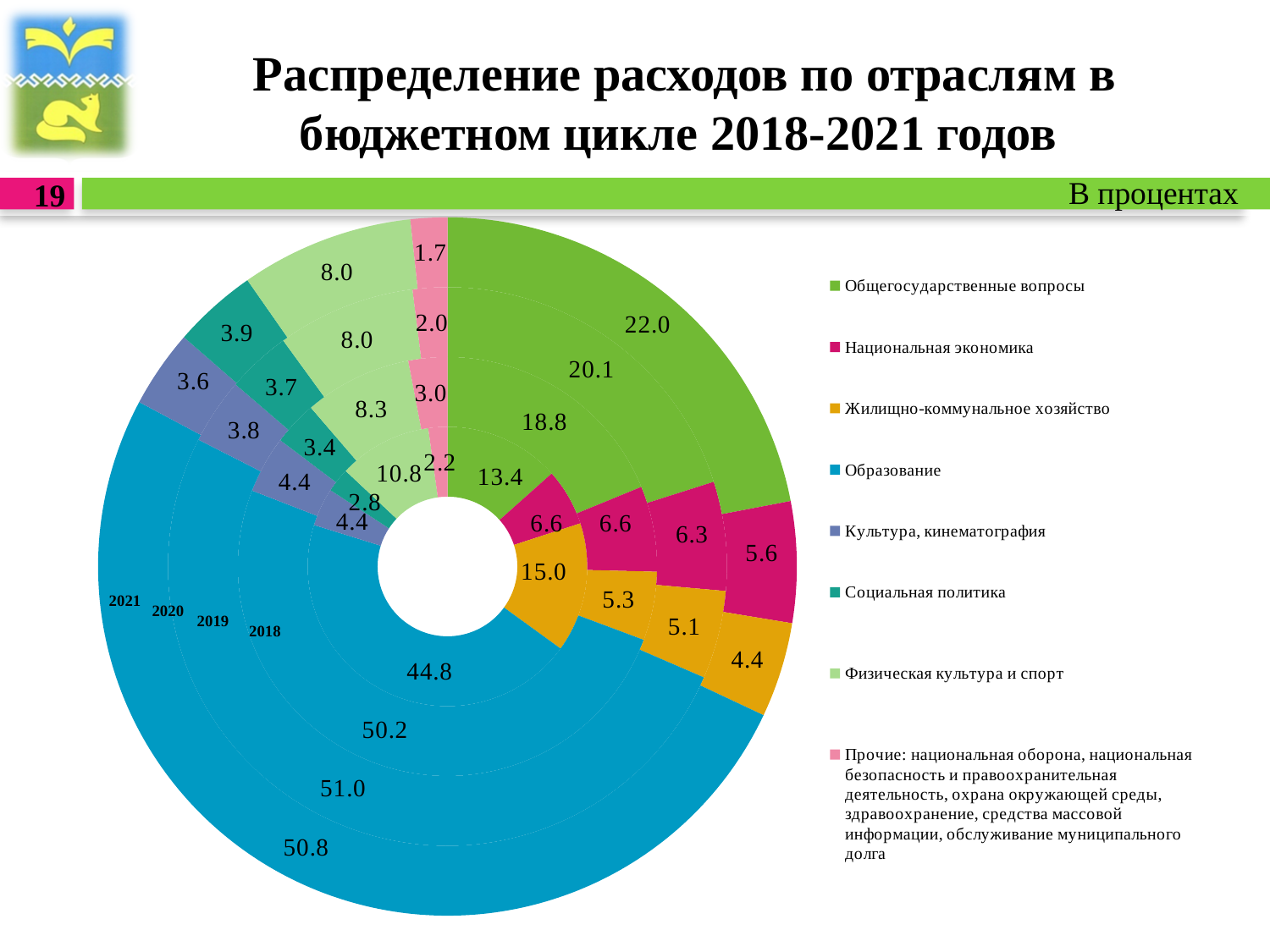
What is the value for Жилищно-коммунальное хозяйство in the 2018 ring? 15.0 Which category has the smallest share in the 2021 ring? Прочие What unit is indicated in the green bar above the chart? В процентах How many entries does the legend list? 8 What kind of chart is shown on the slide? doughnut chart What is the value for Общегосударственные вопросы in the innermost ring (2018)? 13.4 Do the values for Общегосударственные вопросы rise or fall from the 2018 ring to the 2021 ring? rise What is the difference between the Общегосударственные вопросы values in the 2021 ring (22.0) and the 2018 ring (13.4)? 8.6 Which category has the largest share in the 2021 ring? Образование How many rings (years) does the doughnut chart contain? 4 What is the share of Образование in the outermost ring (2021)? 50.8 Which is larger in the 2018 ring: Жилищно-коммунальное хозяйство or Физическая культура и спорт? Жилищно-коммунальное хозяйство